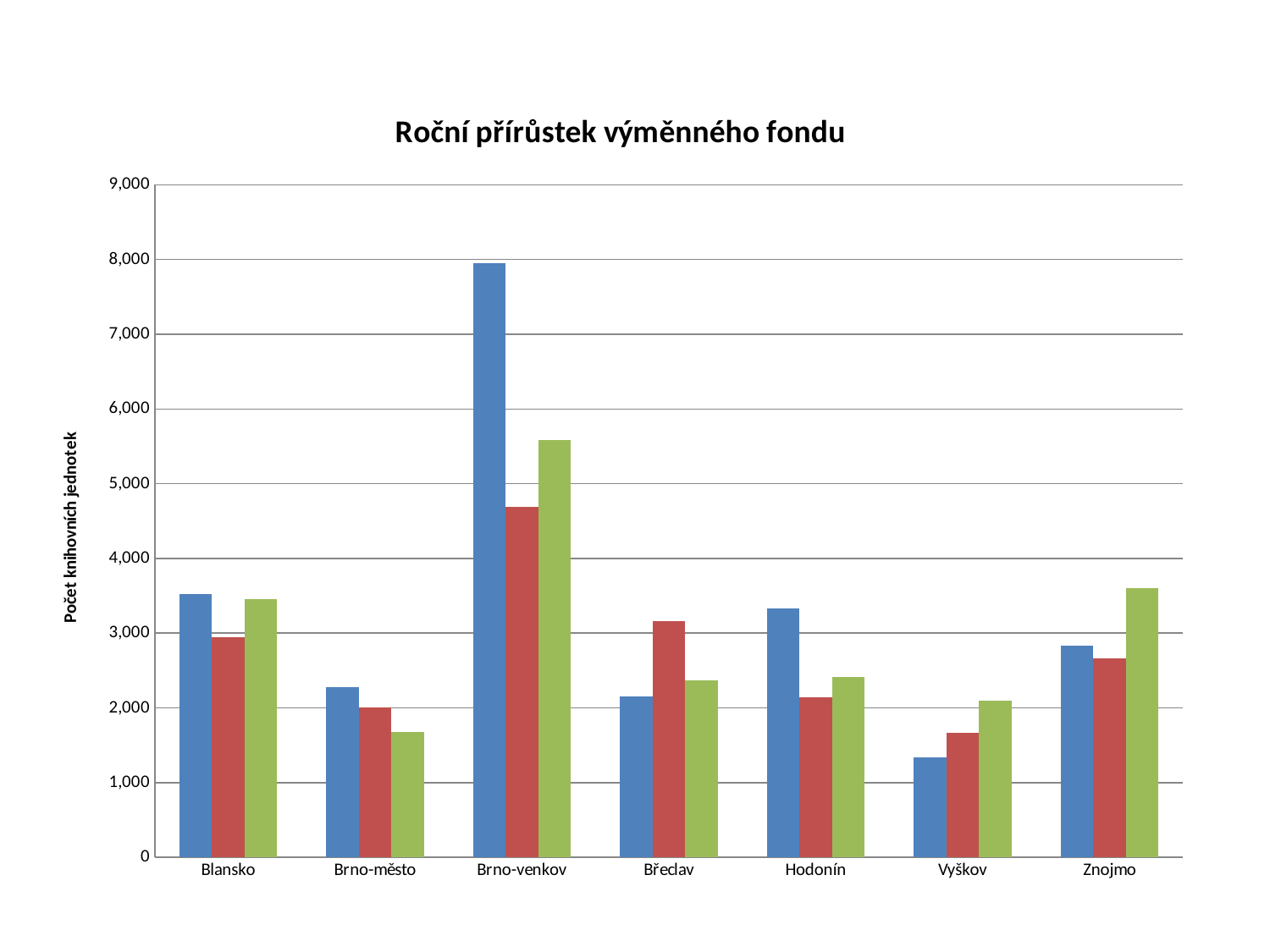
How many bars are shown for each category? 3 How many categories are shown on the x axis? 7 Is the value of the green bar for Brno-město greater or less than 2,000? less What is the title of the chart? Roční přírůstek výměnného fondu Is the value of the red bar for Břeclav greater or less than 3,000? greater Among the blue bars, which category has the lowest value? Vyškov What is the label of the vertical axis? Počet knihovních jednotek For Znojmo, which is larger, the green bar or the blue bar? the green bar What kind of chart is shown on the slide? bar chart Which category has the tallest bar in the chart? Brno-venkov Is the value of the blue bar for Brno-venkov greater or less than 7,000? greater Which is larger, the blue bar for Blansko or the blue bar for Brno-město? Blansko